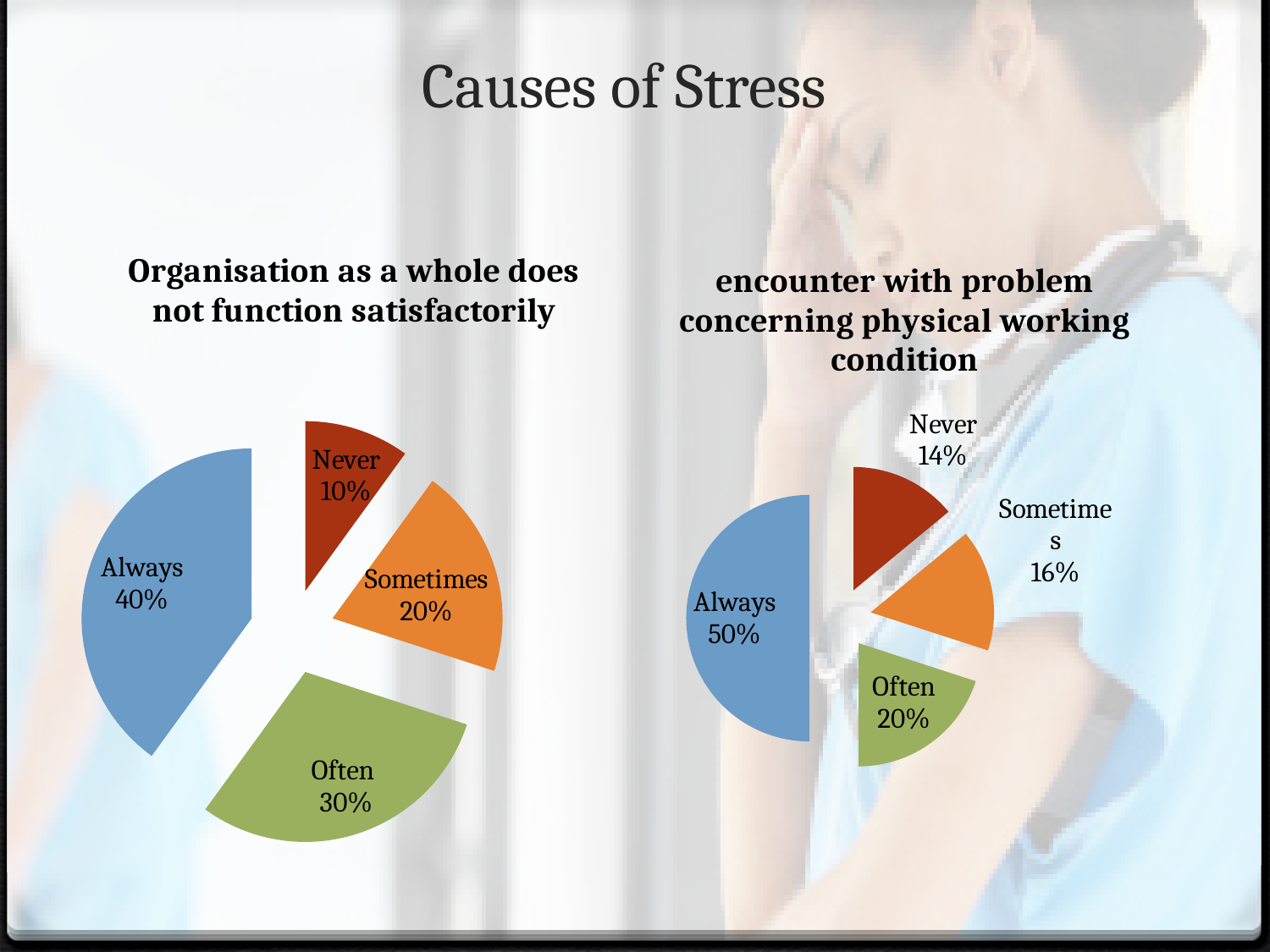
How many slices does the right chart about physical working condition have? 4 In the right chart about physical working condition, what percentage is shown for Sometimes? 16% In the right chart about physical working condition, what percentage is shown for Never? 14% In the left chart titled 'Organisation as a whole does not function satisfactorily', which category has the largest share? Always In the left chart titled 'Organisation as a whole does not function satisfactorily', what percentage is shown for Always? 40% What kind of chart is the left chart titled 'Organisation as a whole does not function satisfactorily'? Pie chart In the right chart about physical working condition, what is the difference between the Always and Often percentages? 30% In the left chart titled 'Organisation as a whole does not function satisfactorily', which is larger, Sometimes or Often? Often In the right chart about physical working condition, which category has the largest share? Always In the left chart titled 'Organisation as a whole does not function satisfactorily', which category has the smallest share? Never In the left chart titled 'Organisation as a whole does not function satisfactorily', what percentage is shown for Often? 30% What is the title of the slide? Causes of Stress